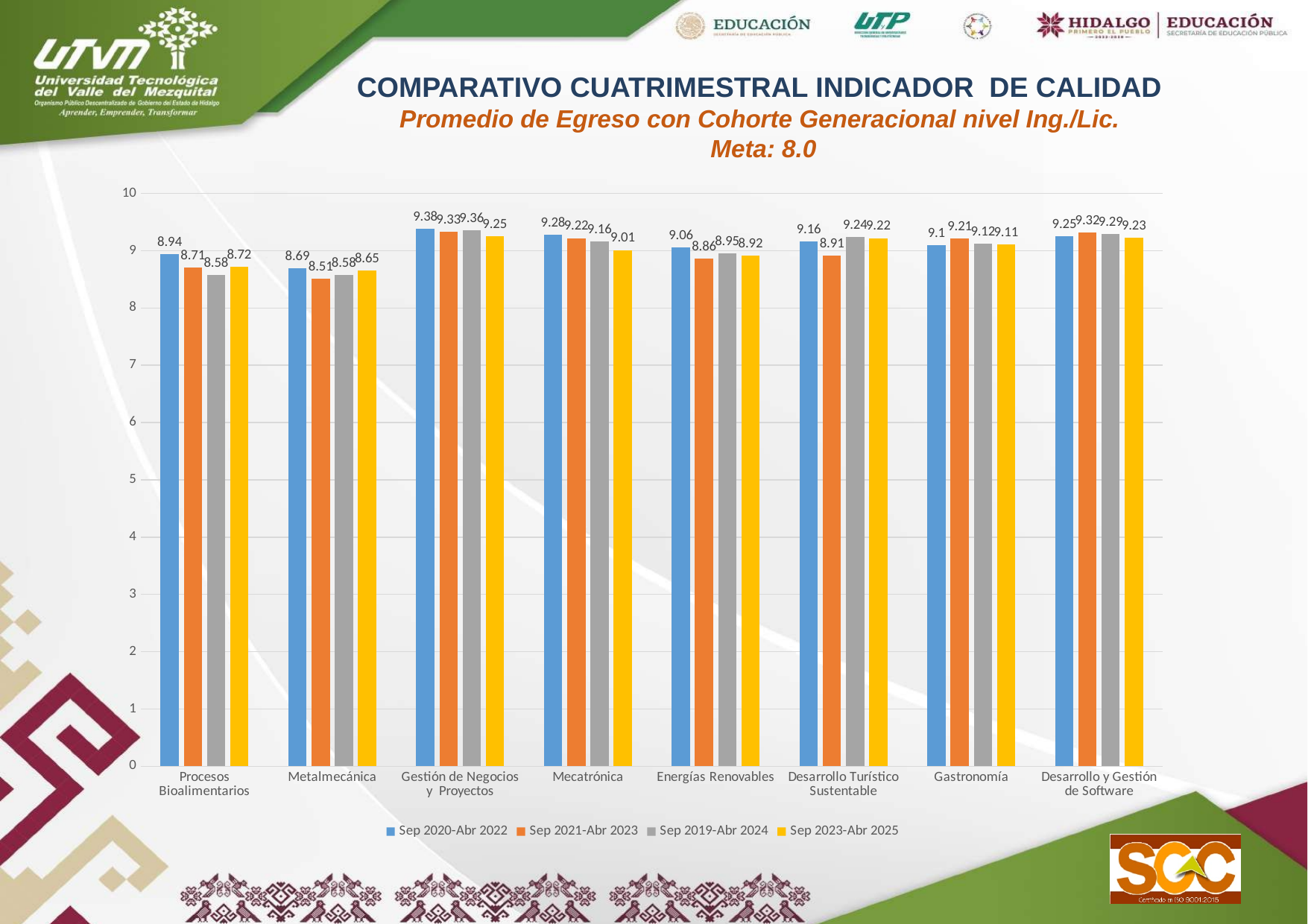
What is the value for Metalmecánica in the Sep 2021-Abr 2023 series? 8.51 What is the value for Mecatrónica in the Sep 2023-Abr 2025 series? 9.01 What is the value for Desarrollo Turístico Sustentable in the Sep 2019-Abr 2024 series? 9.24 Which category has the lowest value in the Sep 2021-Abr 2023 series? Metalmecánica For Gastronomía, which is larger: the Sep 2021-Abr 2023 value or the Sep 2020-Abr 2022 value? Sep 2021-Abr 2023 How many categories are shown on the x axis? 8 Which category has the highest value in the Sep 2020-Abr 2022 series? Gestión de Negocios y Proyectos What is the difference between the Sep 2020-Abr 2022 and Sep 2019-Abr 2024 values for Procesos Bioalimentarios? 0.36 Is the value for Metalmecánica in the Sep 2023-Abr 2025 series greater or less than 9? less What kind of chart is shown on the slide? bar chart How many series does the legend list? 4 What is the value for Procesos Bioalimentarios in the Sep 2020-Abr 2022 series? 8.94